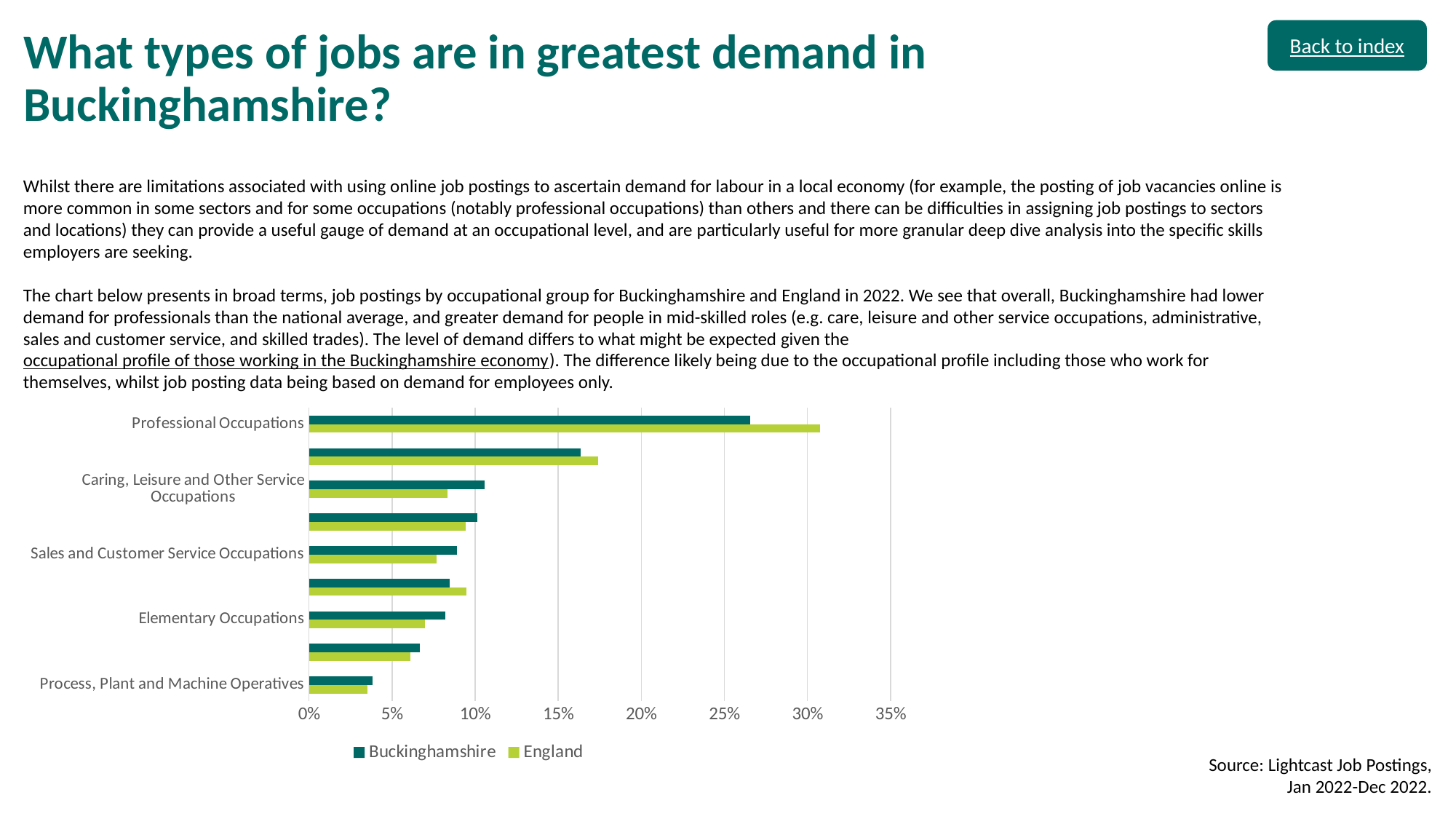
For Professional Occupations, which is larger: the Buckinghamshire value or the England value? England For Caring, Leisure and Other Service Occupations, which is larger: the Buckinghamshire value or the England value? Buckinghamshire Is the England value for Caring, Leisure and Other Service Occupations greater or less than 10%? less Which two series are shown in the chart legend? Buckinghamshire and England Which occupational group has the highest share of job postings for Buckinghamshire? Professional Occupations What kind of chart is shown on the slide? bar chart Is the England value for Professional Occupations greater or less than 30%? greater Is the Buckinghamshire value for Professional Occupations greater or less than 25%? greater Which occupational group has the highest share of job postings for England? Professional Occupations For Sales and Customer Service Occupations, which is larger: the Buckinghamshire value or the England value? Buckinghamshire How many series does the chart legend list? 2